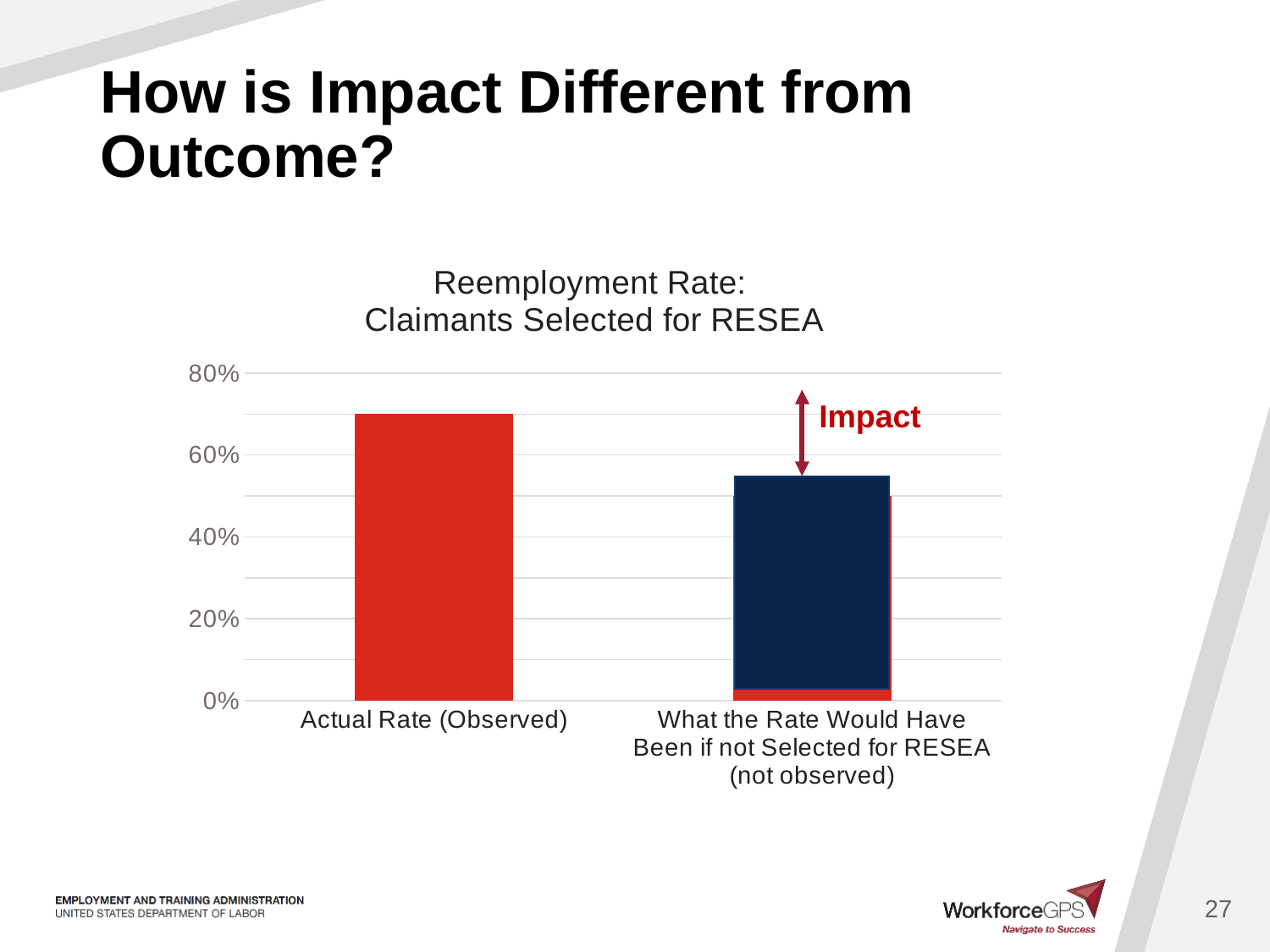
How many bars (categories) does the chart show? 2 Which is larger: the Actual Rate (Observed) or What the Rate Would Have Been if not Selected for RESEA (not observed)? Actual Rate (Observed) Is the value for Actual Rate (Observed) greater or less than 80%? less What kind of chart is shown on the slide? bar chart Which category has the lowest reemployment rate? What the Rate Would Have Been if not Selected for RESEA (not observed) What is the title of the chart? Reemployment Rate: Claimants Selected for RESEA Is the value for What the Rate Would Have Been if not Selected for RESEA (not observed) greater or less than 40%? greater What label is written next to the arrow between the top of the two bars? Impact Is the value for Actual Rate (Observed) greater or less than 60%? greater Which category has the highest reemployment rate? Actual Rate (Observed)